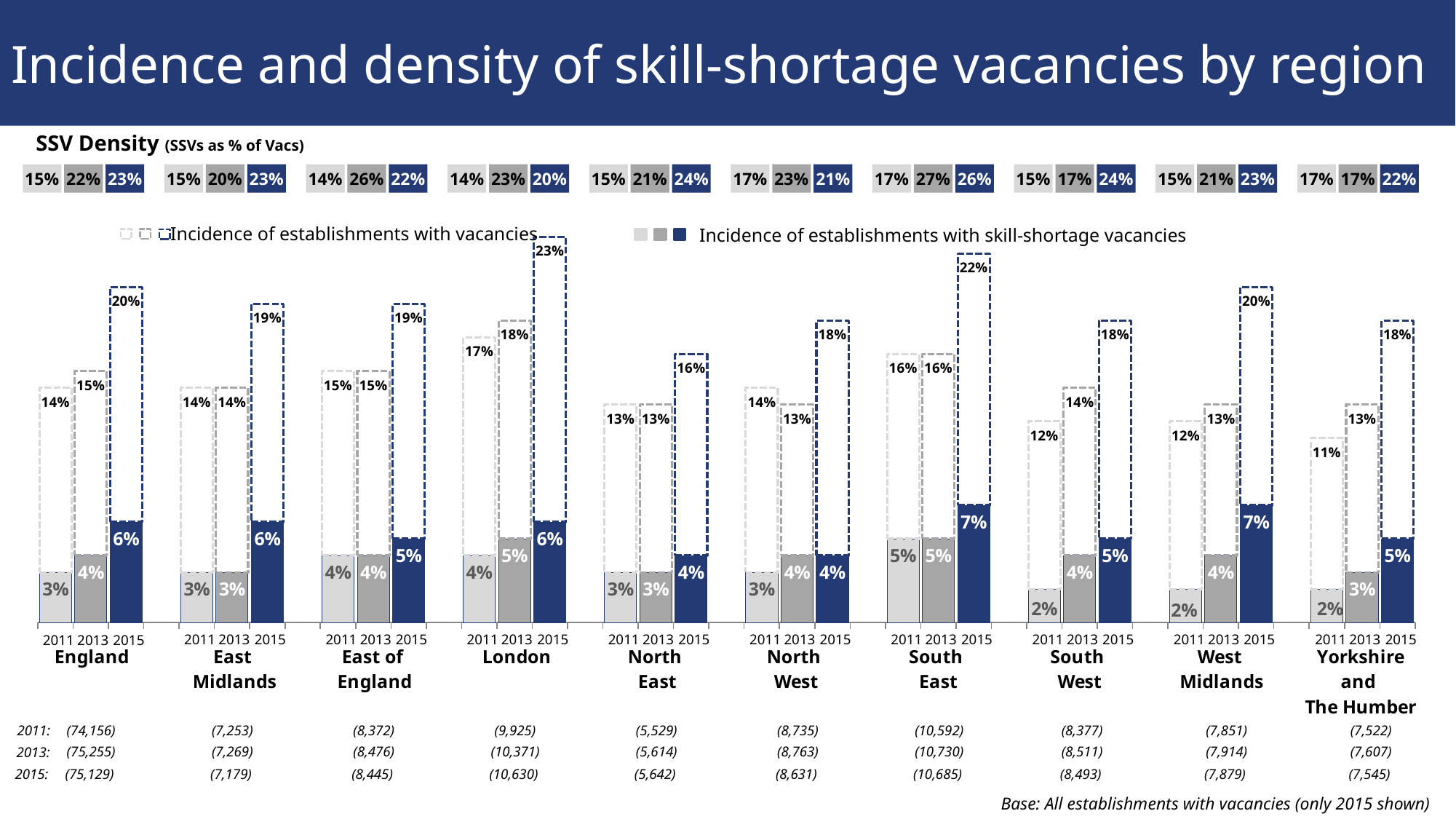
Which region has the highest 2015 incidence of establishments with vacancies? London How many regions are shown on the x axis of the chart? 10 What is the 2013 SSV density for the East of England? 26% Which region has the lowest 2011 incidence of establishments with vacancies? Yorkshire and The Humber What type of chart is used to show incidence of establishments with vacancies and skill-shortage vacancies? Bar chart What is the 2015 SSV density (SSVs as % of vacancies) for the South East? 26% What is the 2015 incidence of establishments with skill-shortage vacancies in the South East? 7% What is the 2015 incidence of establishments with vacancies in London? 23% Is the 2015 incidence of establishments with skill-shortage vacancies higher in the South East or in the North East? South East Does the incidence of establishments with skill-shortage vacancies in England rise or fall from 2011 to 2015? Rise What is the difference between the 2015 and 2011 incidence of establishments with vacancies in the West Midlands? 8 percentage points What is the 2011 incidence of establishments with skill-shortage vacancies in the South West? 2%